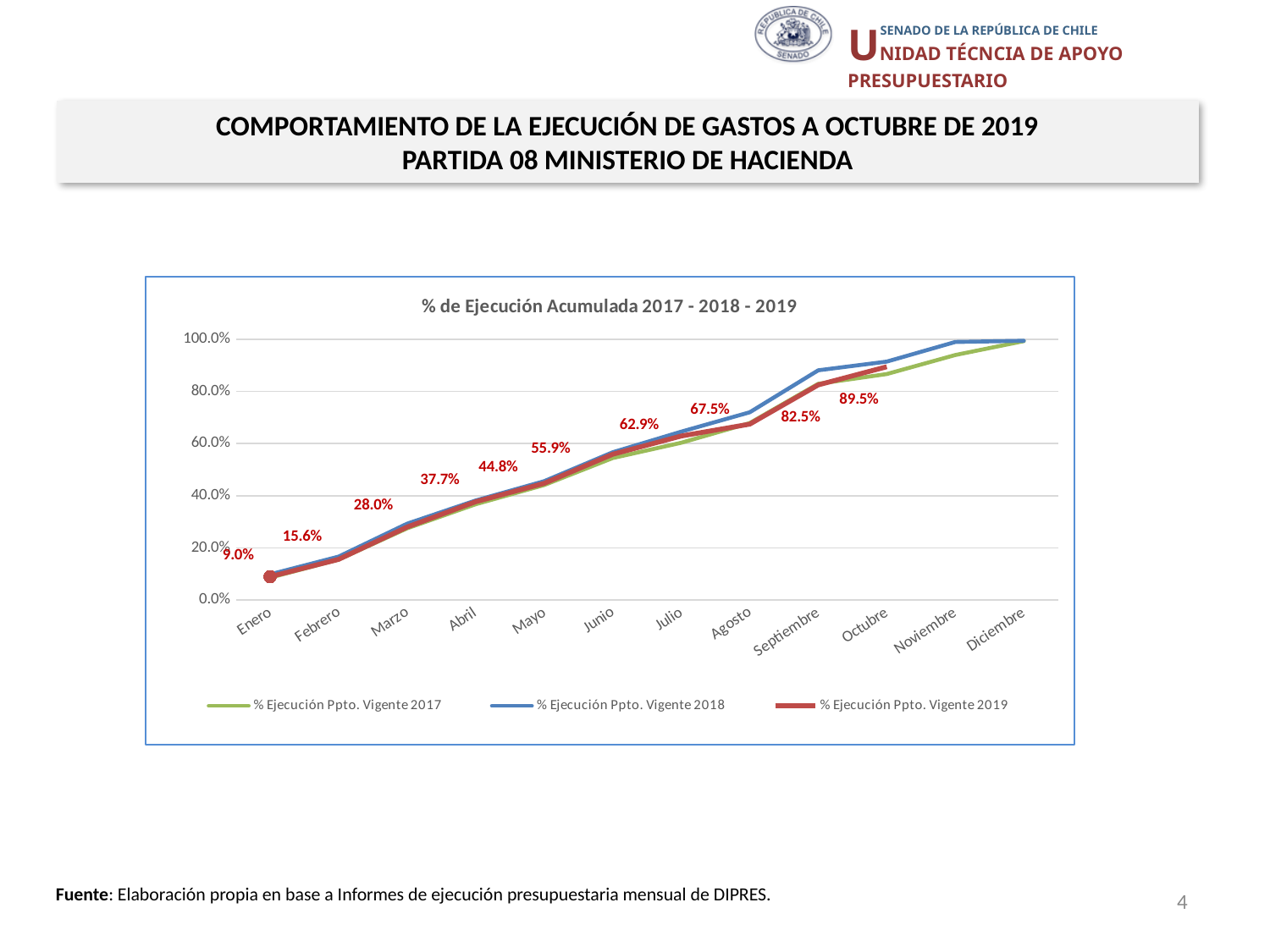
How many series does the legend list? 3 What is the difference between the 2019 values for Octubre and Septiembre? 7.0% Does the % Ejecución Ppto. Vigente 2019 series rise or fall from Enero to Octubre? Rise What is the value of % Ejecución Ppto. Vigente 2019 for Octubre? 89.5% What is the value of % Ejecución Ppto. Vigente 2019 for Junio? 55.9% Which series is drawn in red? % Ejecución Ppto. Vigente 2019 What is the title of the chart? % de Ejecución Acumulada 2017 - 2018 - 2019 What is the value of % Ejecución Ppto. Vigente 2019 for Septiembre? 82.5% How many months are shown on the x axis? 12 What type of chart is shown on the slide? Line chart Is the value of % Ejecución Ppto. Vigente 2018 for Noviembre greater or less than 80.0%? greater What is the value of % Ejecución Ppto. Vigente 2019 for Enero? 9.0%